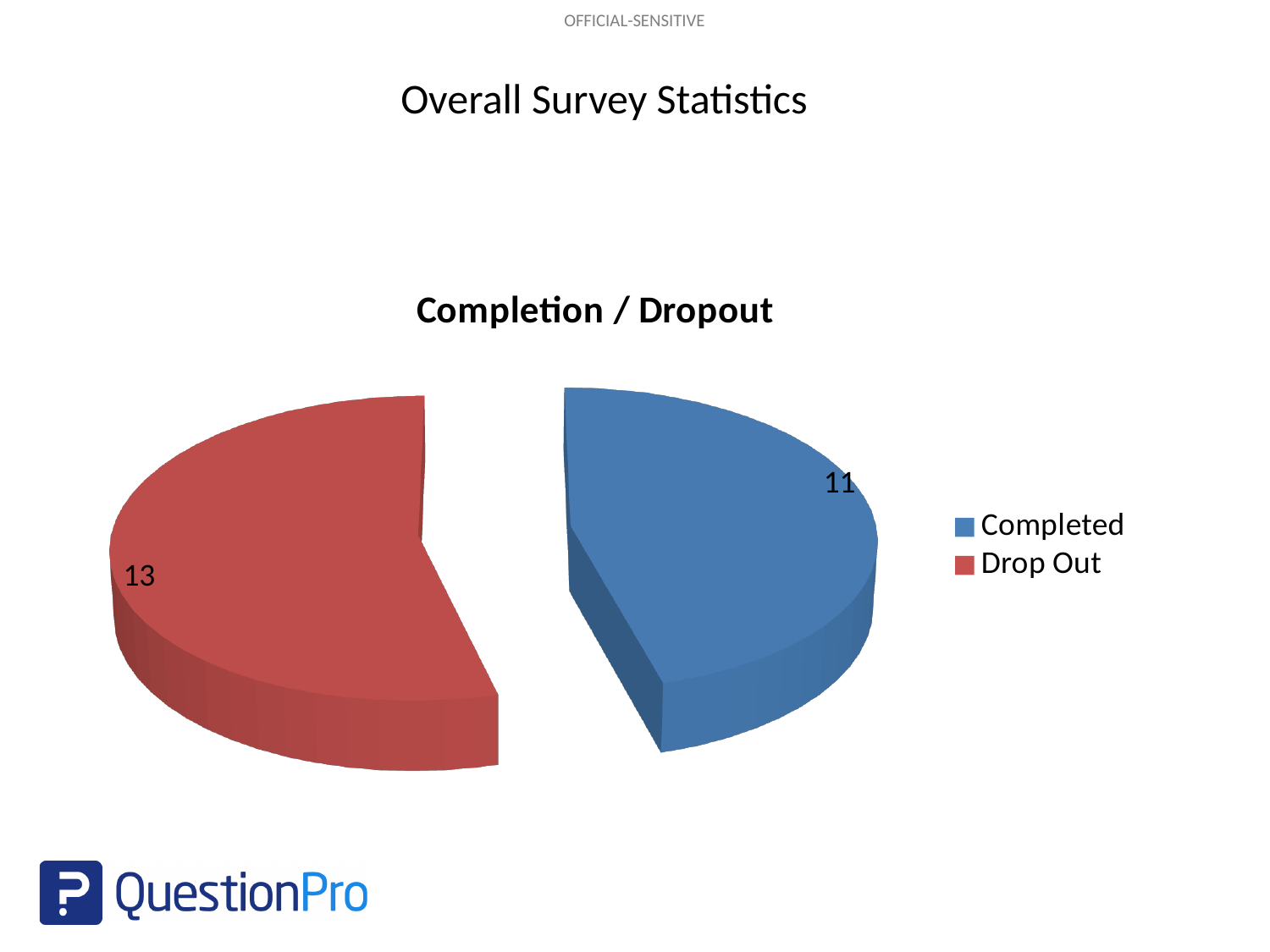
Which category has the largest slice? Drop Out What kind of chart is shown? Pie chart What is the title of the chart? Completion / Dropout What is the value for Drop Out? 13 Which category has the smallest slice? Completed What is the difference between the Drop Out and Completed values? 2 What is the total of all slices in the pie chart? 24 What colour is the Drop Out slice? Red How many slices does the pie chart have? 2 What is the value for Completed? 11 Which is larger, Completed or Drop Out? Drop Out